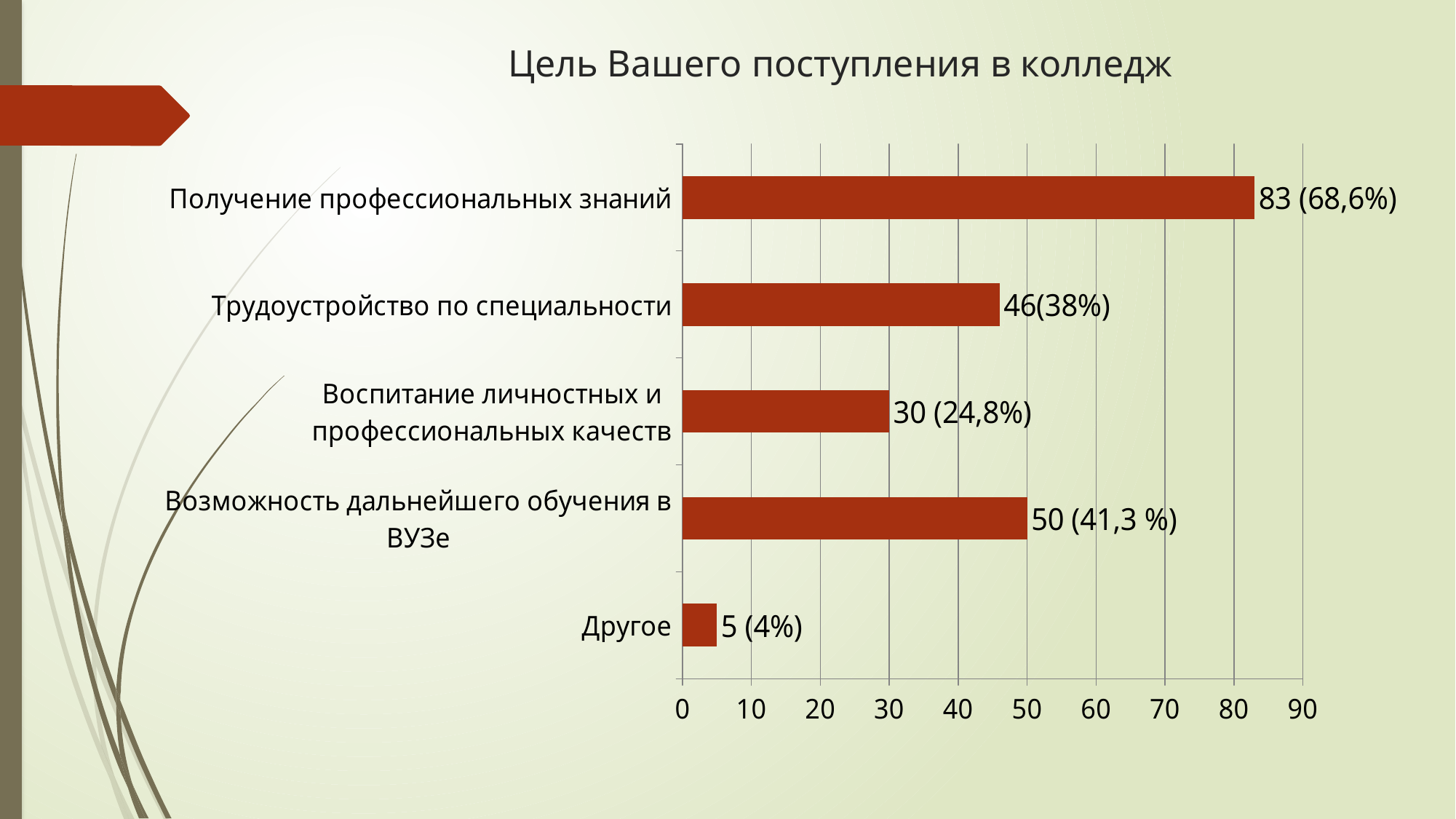
What is the difference between the counts for «Получение профессиональных знаний» and «Трудоустройство по специальности»? 37 What is the value for «Другое»? 5 (4%) What is the value for «Трудоустройство по специальности»? 46(38%) What is the value for «Получение профессиональных знаний»? 83 (68,6%) What is the value for «Возможность дальнейшего обучения в ВУЗе»? 50 (41,3 %) Which category has the lowest value? Другое How many categories are shown in the chart? 5 What is the title of the chart? Цель Вашего поступления в колледж Which is larger: the value for «Возможность дальнейшего обучения в ВУЗе» or for «Трудоустройство по специальности»? Возможность дальнейшего обучения в ВУЗе What is the value for «Воспитание личностных и профессиональных качеств»? 30 (24,8%) Which category has the highest value? Получение профессиональных знаний What kind of chart is shown on the slide? Bar chart